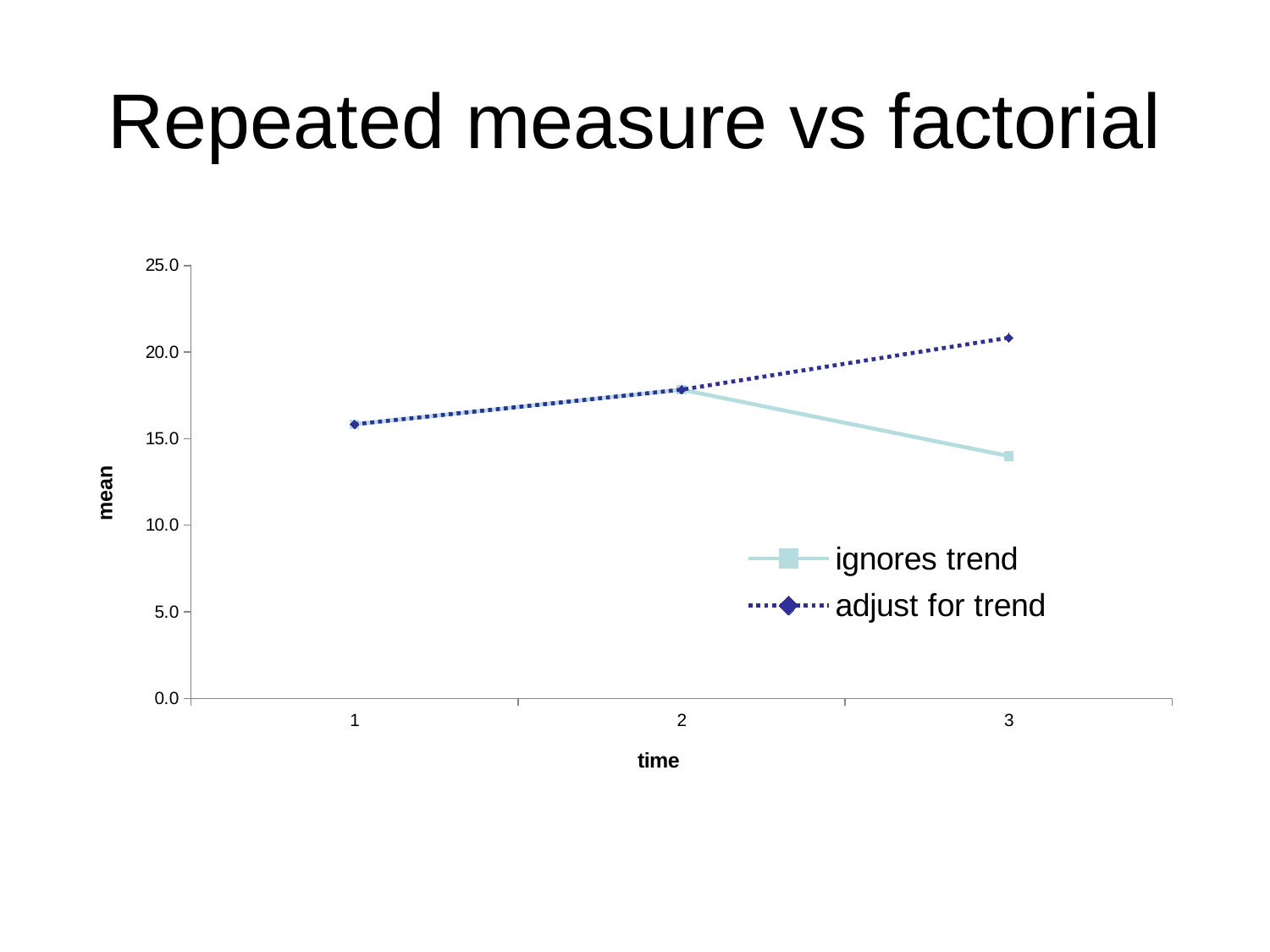
What is the title of the slide? Repeated measure vs factorial How many time points are plotted on the x axis? 3 Is the mean for 'ignores trend' at time 3 greater or less than 15.0? less At time 3, which series has the higher mean, 'ignores trend' or 'adjust for trend'? adjust for trend Is the mean for 'ignores trend' at time 1 greater or less than 10.0? greater How many series does the legend list? 2 Does the 'ignores trend' series rise or fall from time 2 to time 3? fall What is the label on the y axis of the chart? mean What kind of chart is shown on the slide? line chart Is the mean for 'adjust for trend' at time 2 greater or less than 15.0? greater Does the 'adjust for trend' series rise or fall from time 1 to time 3? rise